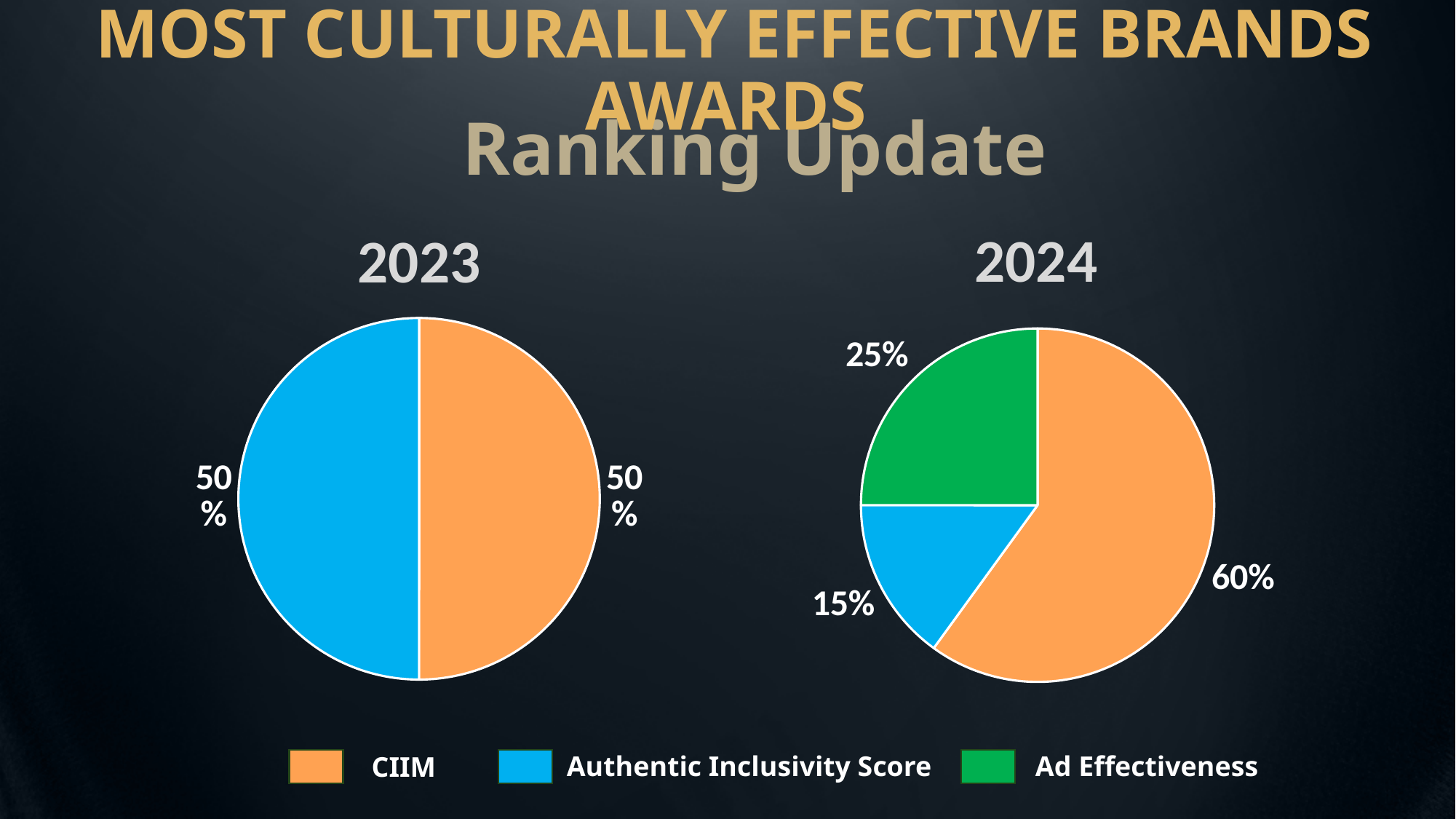
In the 2023 pie chart, what share does CIIM have? 50% What type of charts are shown on the slide? Pie charts In the 2024 pie chart, what share does Ad Effectiveness have? 25% How many slices does the 2024 pie chart have? 3 In the 2024 pie chart, what share does CIIM have? 60% In the 2024 pie chart, which is larger: Ad Effectiveness or Authentic Inclusivity Score? Ad Effectiveness In the 2024 pie chart, what is the difference between the CIIM share and the Ad Effectiveness share? 35% In the 2024 pie chart, which category has the smallest share? Authentic Inclusivity Score How many entries does the legend list? 3 How many slices does the 2023 pie chart have? 2 In the 2024 pie chart, which category has the largest share? CIIM In the 2024 pie chart, what share does Authentic Inclusivity Score have? 15%